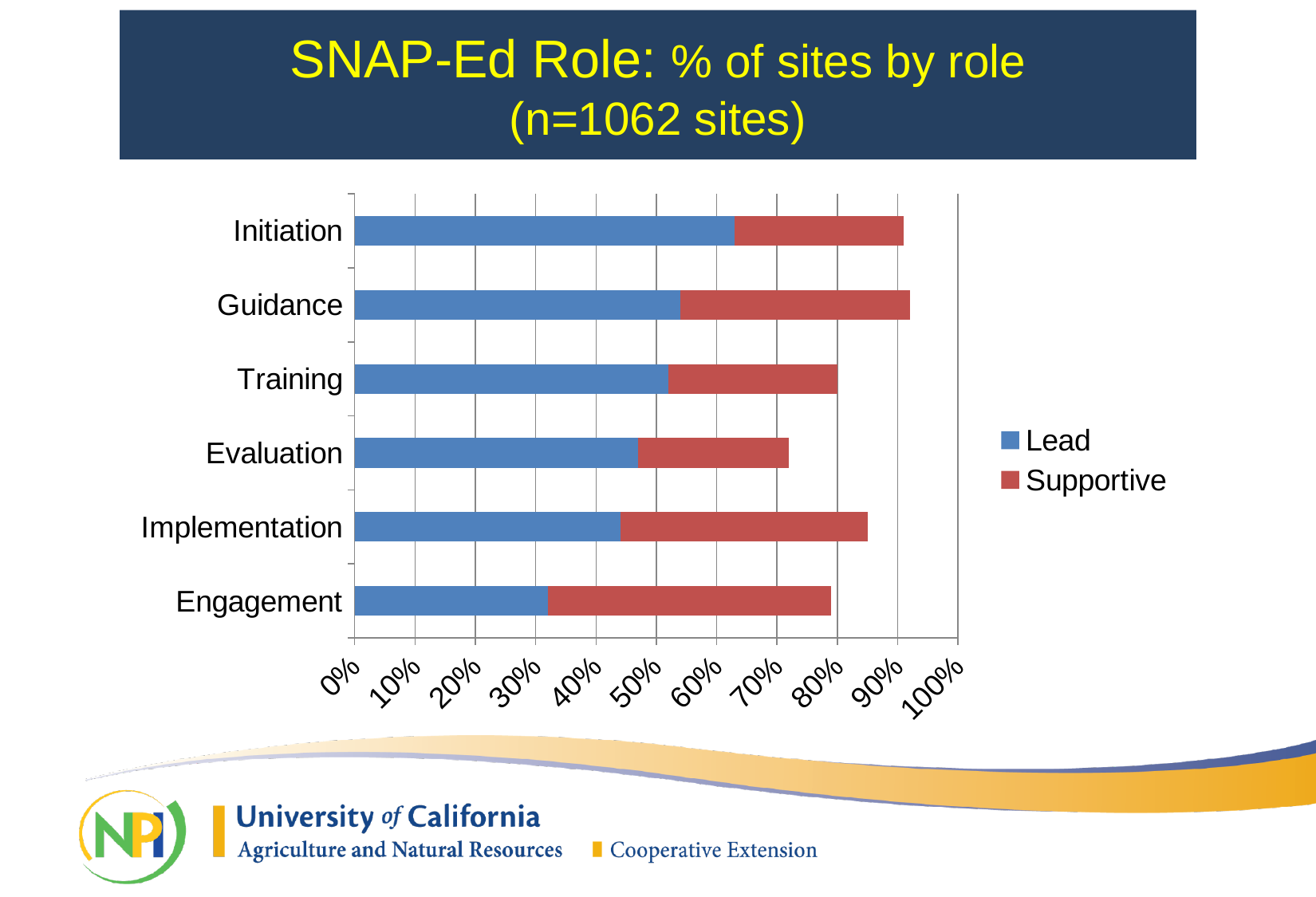
Is the Lead value for Implementation greater or less than 50%? less Which role has the lowest Lead value? Engagement Is the Lead value for Engagement greater or less than 40%? less Which role has the largest Supportive segment? Engagement Which two series are listed in the chart legend? Lead and Supportive Which role has the shortest total bar (Lead plus Supportive)? Evaluation Is the Lead value for Initiation greater or less than 60%? greater How many series does the legend list? 2 Which is larger, the Lead value for Initiation or the Lead value for Guidance? Initiation What kind of chart is shown on the slide? Stacked bar chart How many categories (roles) are plotted on the chart? 6 Which role has the highest Lead value? Initiation